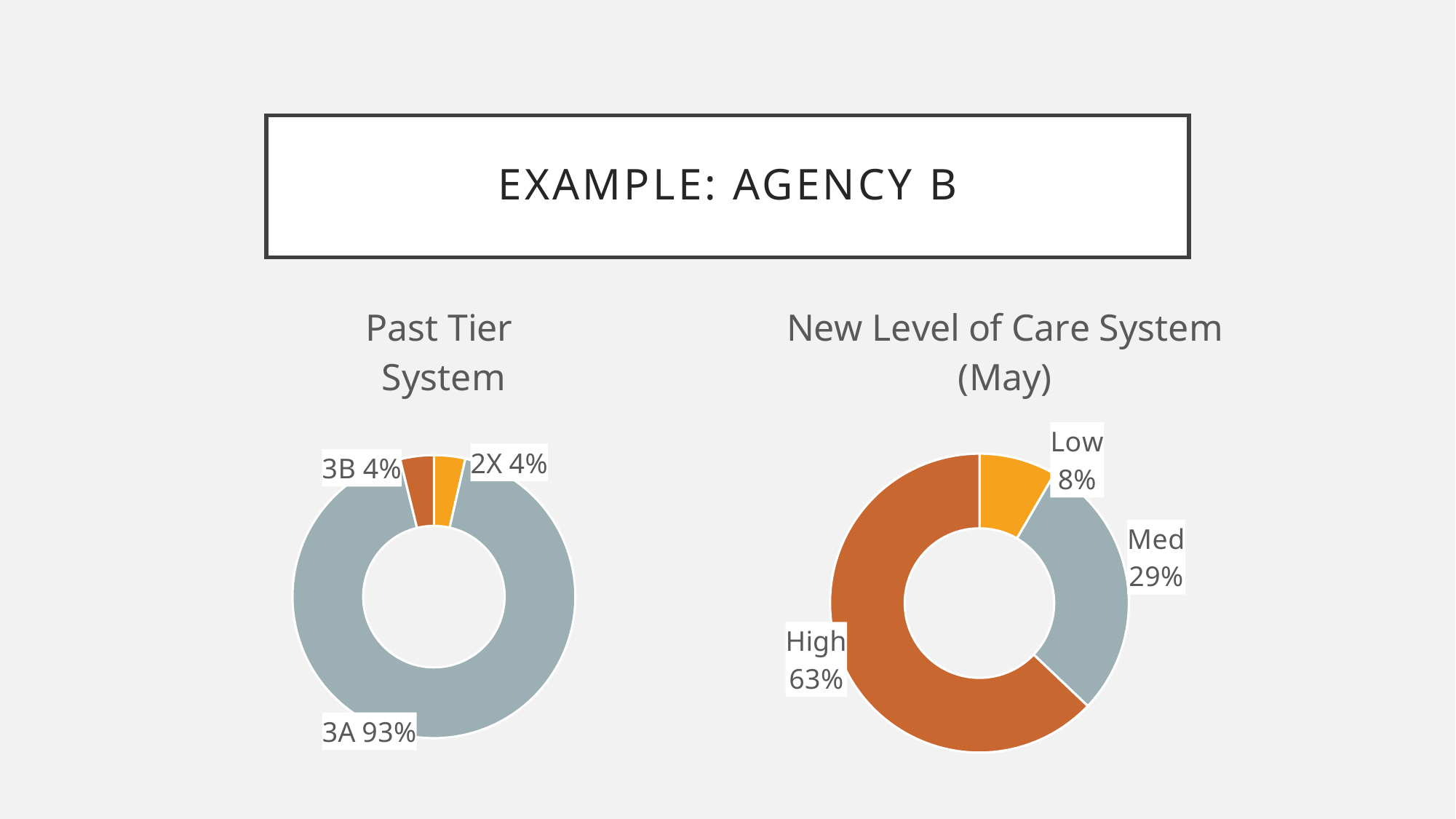
In the 'Past Tier System' chart, how many categories are shown? 3 In the 'New Level of Care System (May)' chart, what share does Med have? 29% In the 'Past Tier System' chart, which category has the largest share? 3A What is the title of the chart on the left of the slide? Past Tier System In the 'New Level of Care System (May)' chart, which category has the smallest share? Low In the 'New Level of Care System (May)' chart, what share does Low have? 8% In the 'New Level of Care System (May)' chart, which is larger, High or Med? High In the 'New Level of Care System (May)' chart, what is the difference between the shares of High and Med? 34% In the 'Past Tier System' chart, what share does 3A have? 93% In the 'Past Tier System' chart, what is the difference between the shares of 3A and 2X? 89% What type of chart is the 'New Level of Care System (May)' chart? Doughnut chart In the 'Past Tier System' chart, what share does 3B have? 4%